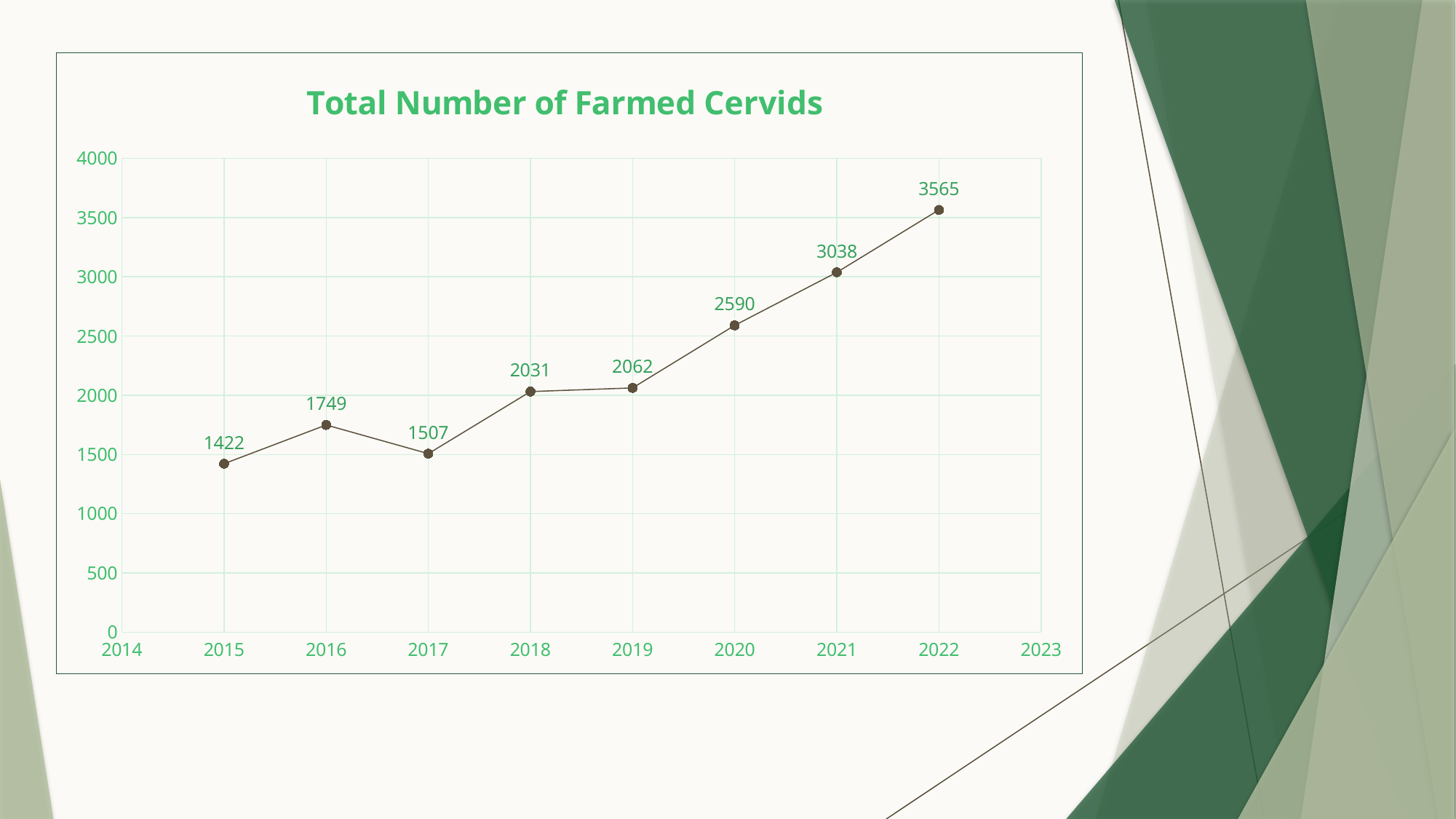
How many data points are plotted on the chart? 8 What is the difference between the number of farmed cervids in 2022 and in 2021? 527 Which year has the lowest total number of farmed cervids? 2015 What is the total number of farmed cervids in 2019? 2062 What is the difference between the number of farmed cervids in 2016 and in 2017? 242 What is the total number of farmed cervids in 2015? 1422 Which year has more farmed cervids, 2016 or 2017? 2016 What kind of chart is shown on the slide? Line chart Is the value for 2020 greater or less than 2500? greater What is the total number of farmed cervids in 2022? 3565 Which year has the highest total number of farmed cervids? 2022 What is the title of the chart? Total Number of Farmed Cervids